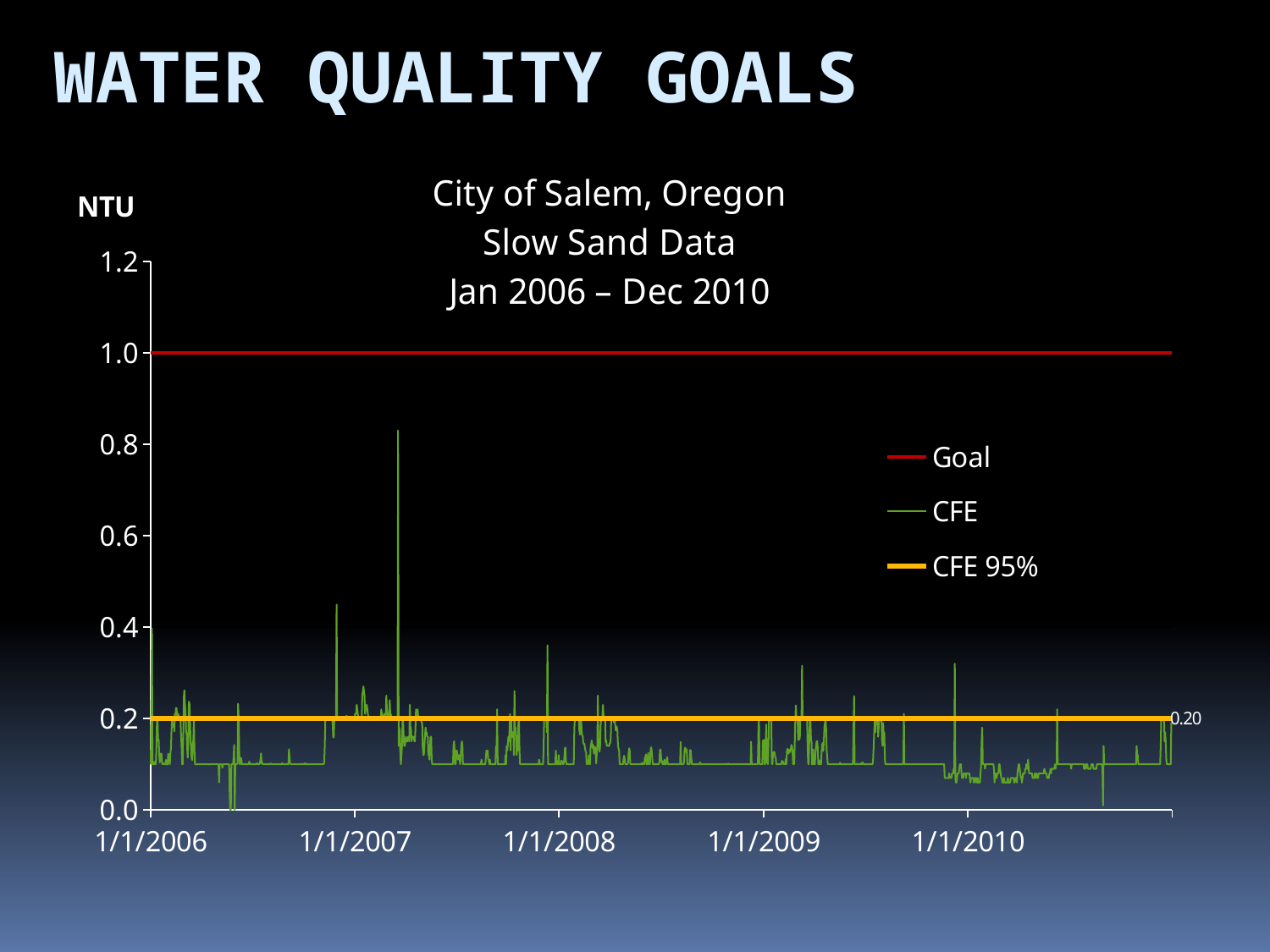
Which series has the highest values on the chart? Goal Is the highest spike of the CFE series greater or less than 0.6? greater What kind of chart is shown on the slide? line chart What colour is the Goal line in the legend? red How many series does the legend list? 3 Which is larger, the Goal line or the CFE 95% line? Goal What is the difference between the Goal value and the CFE 95% value? 0.80 Is the Goal line greater or less than 0.8? greater What value is labelled on the CFE 95% line? 0.20 At what NTU value does the Goal line sit? 1.0 What unit is shown on the y axis label? NTU Does the Goal line rise, fall, or stay flat across the x axis? stays flat